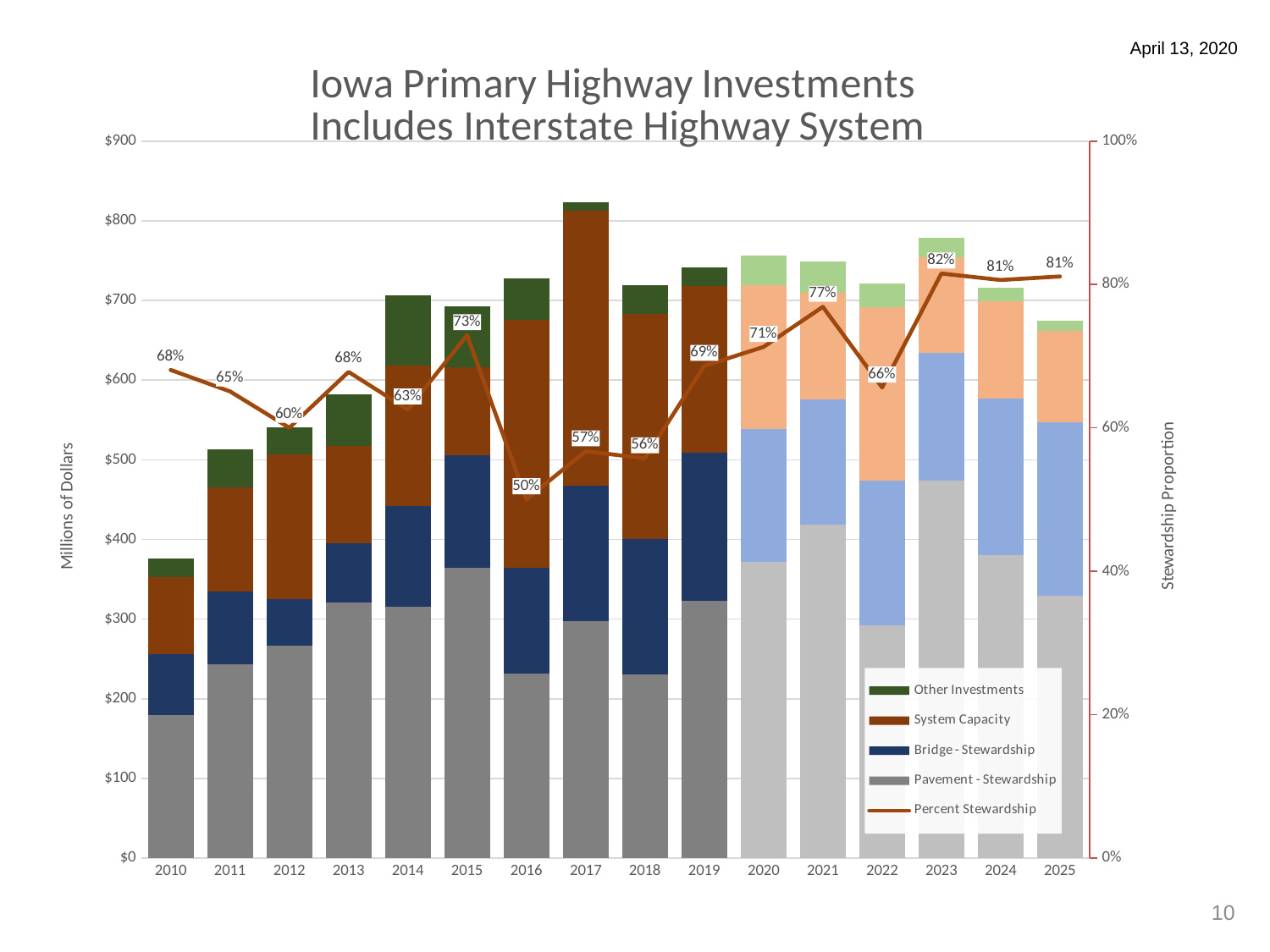
Is the total investment bar for 2017 greater or less than $800 million? greater Is the total investment bar for 2010 greater or less than $400 million? less How many series does the legend list? 5 What is the Percent Stewardship value for 2016? 50% What is the Percent Stewardship value for 2023? 82% How many years are shown on the x axis? 16 Does the Percent Stewardship value rise or fall from 2010 to 2012? fall Which year has the lowest Percent Stewardship value? 2016 Which year has a higher Percent Stewardship value, 2015 or 2021? 2021 What is the Percent Stewardship value for 2010? 68% Which year has the highest Percent Stewardship value? 2023 What is the difference between the Percent Stewardship values for 2023 and 2016? 32 percentage points